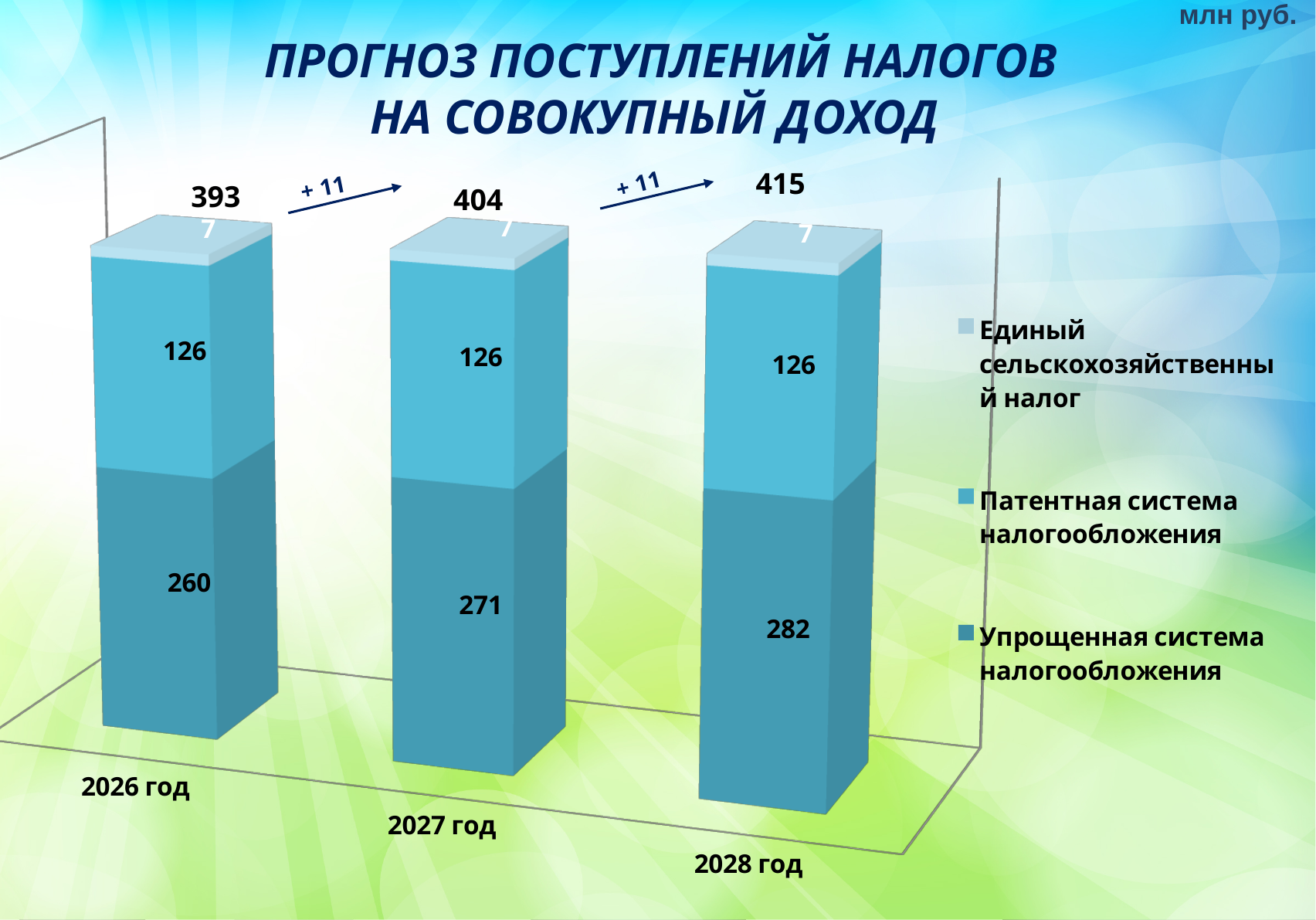
What is the difference between the totals for 2028 год and 2026 год? 22 What is the total of the stacked bar for 2027 год? 404 How many years are shown on the x axis? 3 Which year has the highest total? 2028 год Which year has the lowest value for Упрощенная система налогообложения? 2026 год What is the value for Упрощенная система налогообложения in 2026 год? 260 What is the value for Упрощенная система налогообложения in 2028 год? 282 Which is larger: Упрощенная система налогообложения in 2027 год or Патентная система налогообложения in 2027 год? Упрощенная система налогообложения What is the value for Патентная система налогообложения in 2027 год? 126 How many series does the legend list? 3 Do the totals rise or fall from 2026 год to 2028 год? rise What is the value for Единый сельскохозяйственный налог in 2026 год? 7